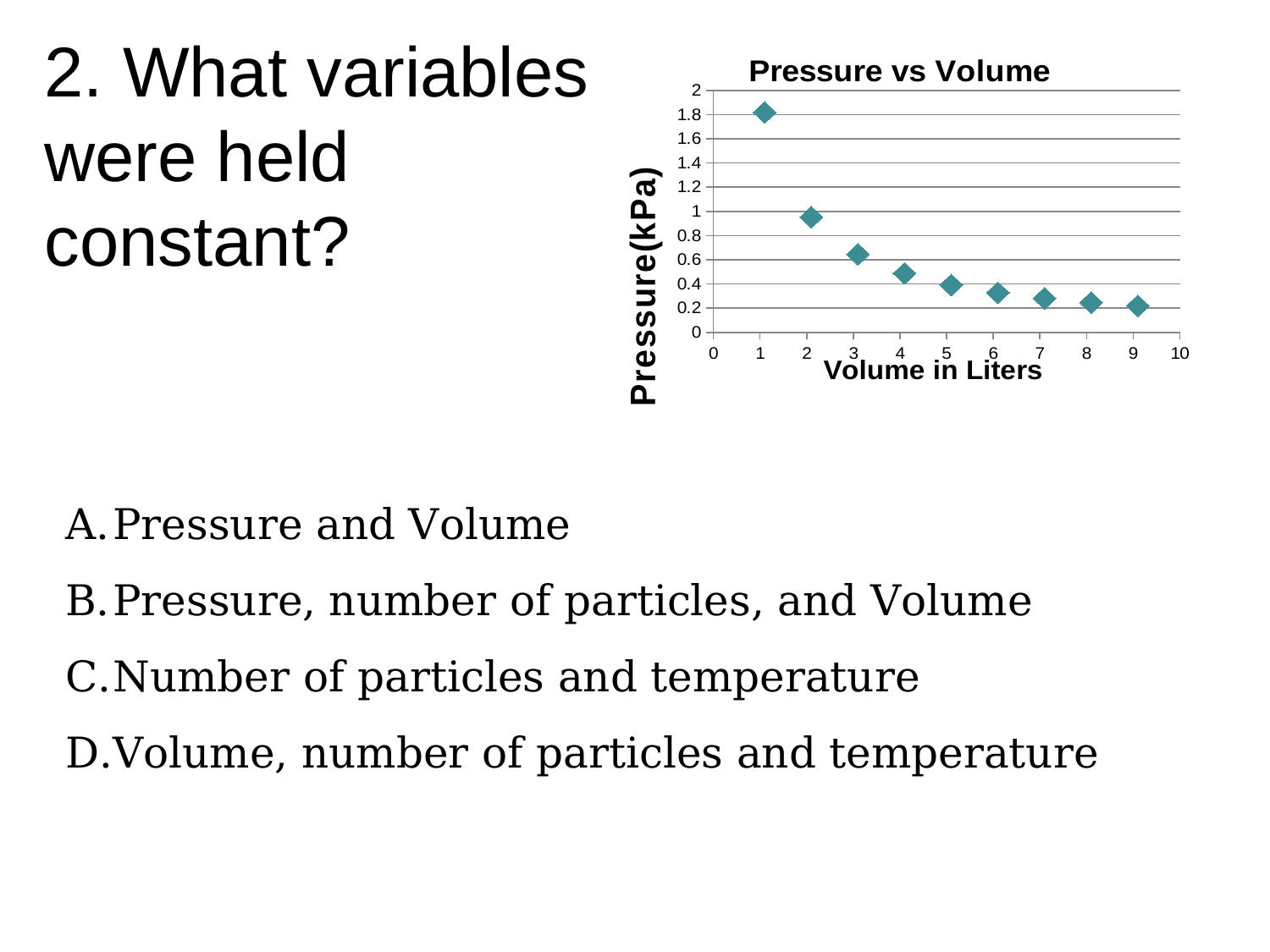
Which has the larger pressure value: the point at volume 2 or the point at volume 6? volume 2 Is the pressure at a volume of 1 liter greater or less than 1.6? greater Is the pressure at a volume of 9 liters greater or less than 0.4? less What is the title of the chart? Pressure vs Volume What kind of chart is shown on the slide? scatter chart Do the pressure values rise or fall as volume increases along the x axis? fall Is the pressure at a volume of 4 liters greater or less than 0.2? greater How many data points are plotted on the chart? 9 What is the label of the vertical axis of the chart? Pressure(kPa)